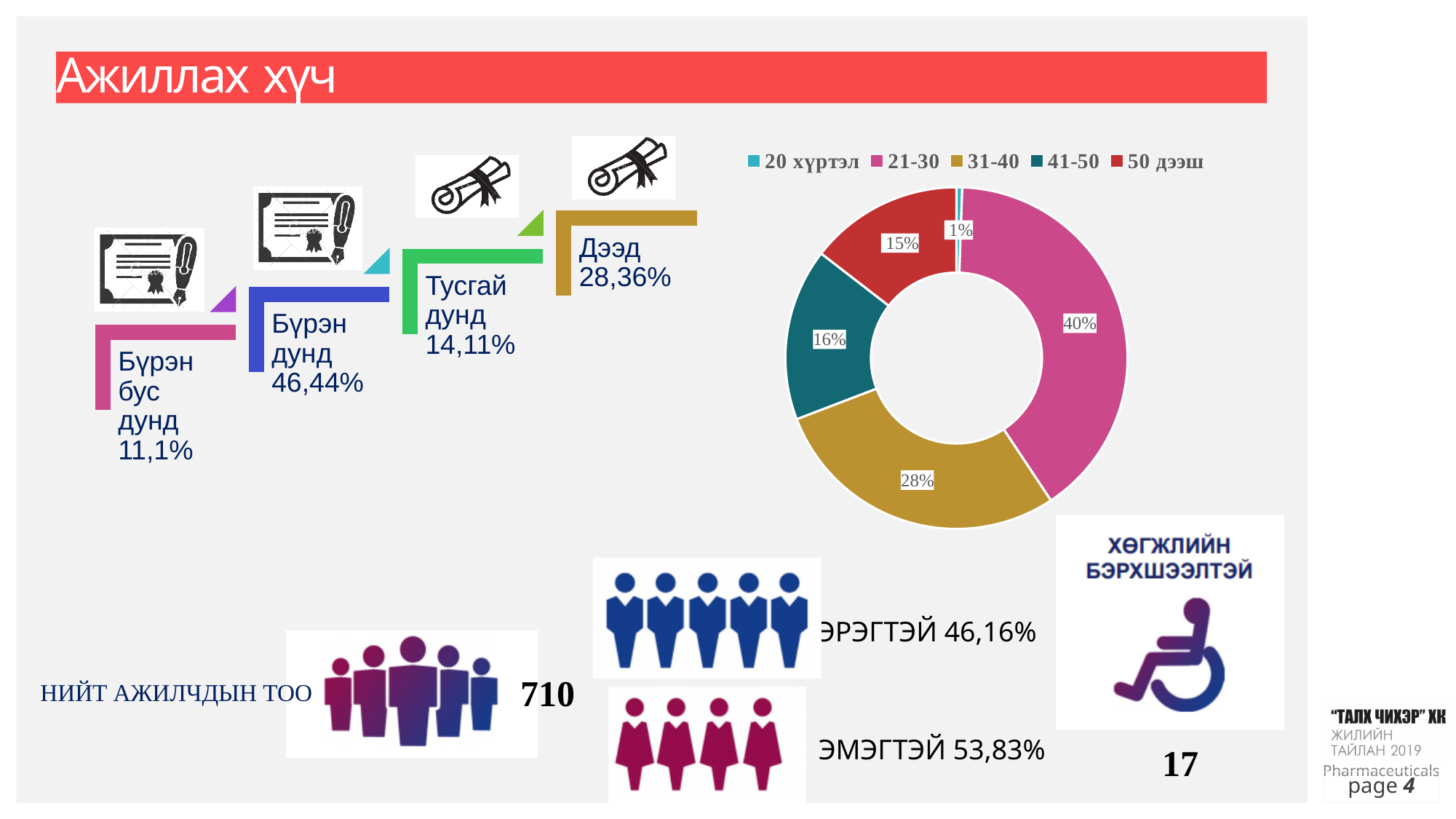
What share of the doughnut chart is the 21-30 age group? 40% What share of the doughnut chart is the 20 хүртэл age group? 1% What colour is the 21-30 segment in the doughnut chart? Pink What share of the doughnut chart is the 50 дээш age group? 15% In the doughnut chart, which has a larger share: 41-50 or 50 дээш? 41-50 In the doughnut chart, what is the difference between the shares of the 21-30 and 31-40 age groups? 12% Which age group has the smallest share in the doughnut chart? 20 хүртэл Which age group has the largest share in the doughnut chart? 21-30 How many age groups does the legend of the doughnut chart list? 5 What share of the doughnut chart is the 41-50 age group? 16% What kind of chart is used to show the age groups on the slide? Doughnut chart What share of the doughnut chart is the 31-40 age group? 28%